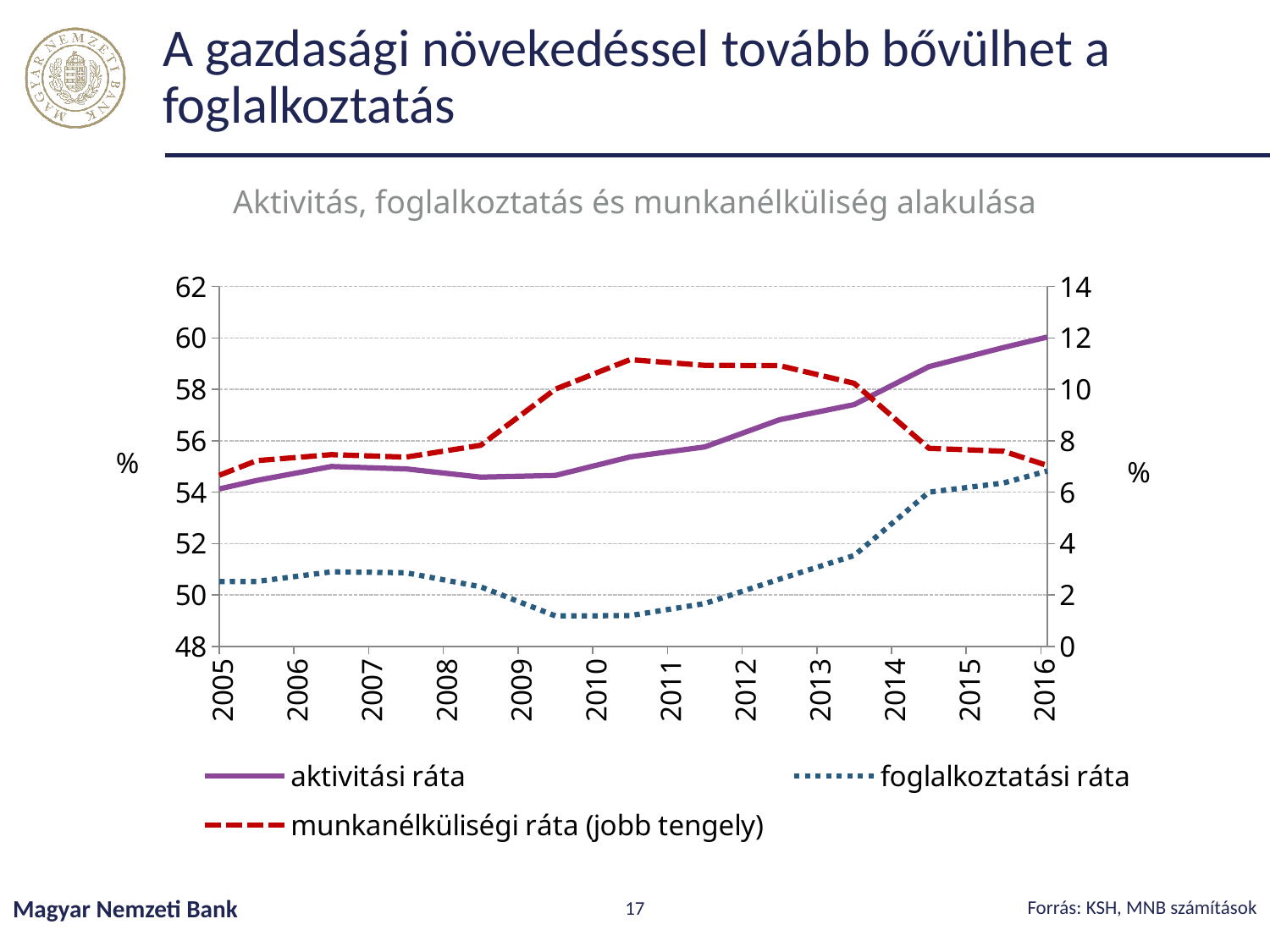
Does the aktivitási ráta rise or fall between 2012 and 2016? rise Which series is plotted on the right axis according to the legend? munkanélküliségi ráta Is the value of the aktivitási ráta in 2005 greater or less than 56? less What is the title of the chart? Aktivitás, foglalkoztatás és munkanélküliség alakulása Is the value of the munkanélküliségi ráta (right axis) in 2005 greater or less than 8? less How many years are labelled on the x axis? 12 Is the value of the aktivitási ráta in 2016 greater or less than 58? greater How many series does the legend list? 3 What kind of chart is shown on the slide? line chart Which is higher in 2010: the aktivitási ráta or the foglalkoztatási ráta? aktivitási ráta